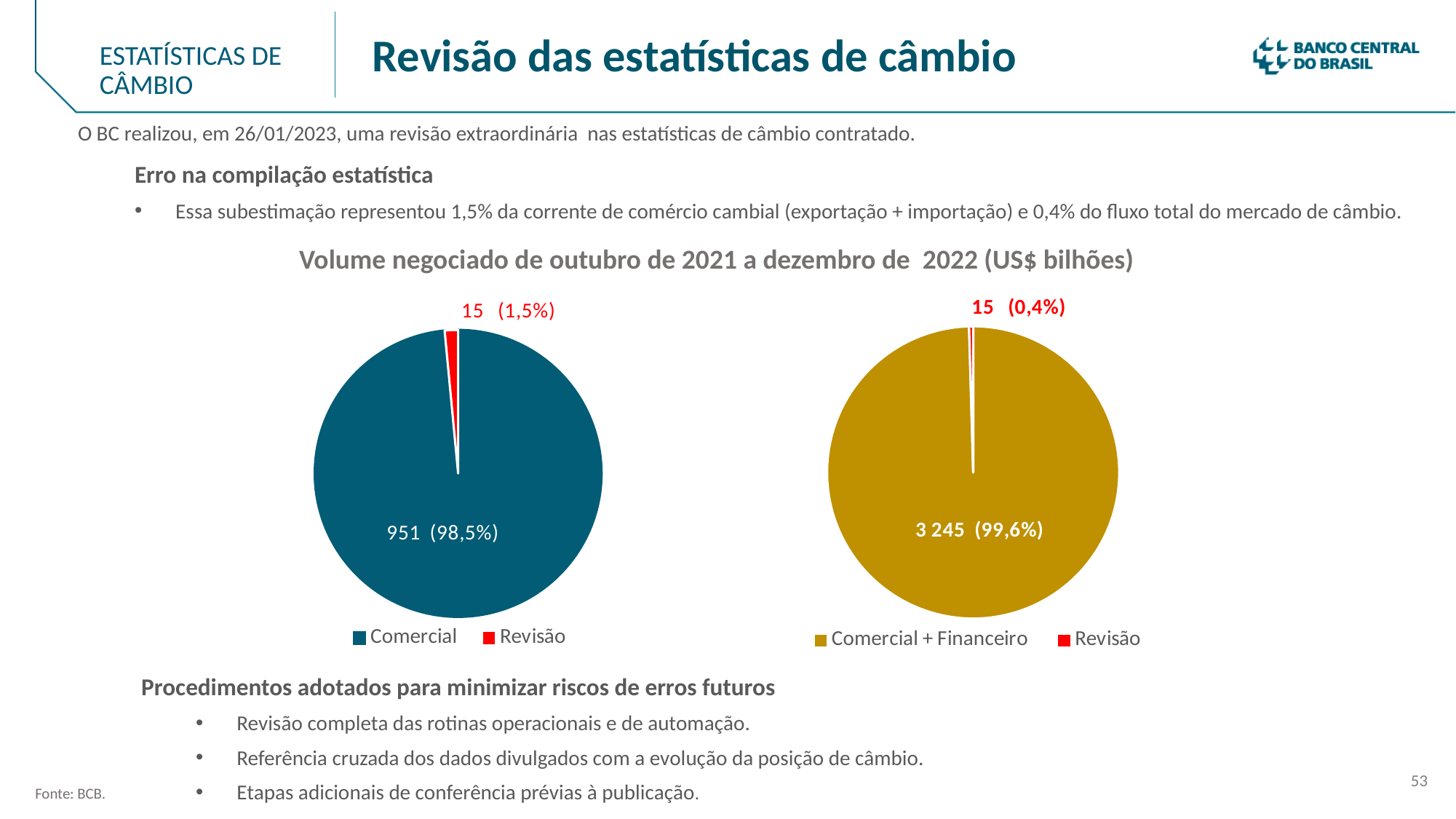
What type of chart is used on the left side of the slide? Pie chart In the right pie chart, what is the value for Revisão? 15 In the right pie chart, what share of the pie does Comercial + Financeiro represent? 99,6% In the left pie chart, what is the value for Comercial? 951 In the left pie chart, what is the difference between the Comercial value and the Revisão value? 936 In the right pie chart, what share of the pie does Revisão represent? 0,4% In the right pie chart, what is the value for Comercial + Financeiro? 3 245 In the left pie chart, what is the value for Revisão? 15 In the left pie chart, what share of the pie does Revisão represent? 1,5% In the left pie chart, which slice is the largest? Comercial How many entries does the legend of the right pie chart list? 2 In the right pie chart, which slice is the smallest? Revisão